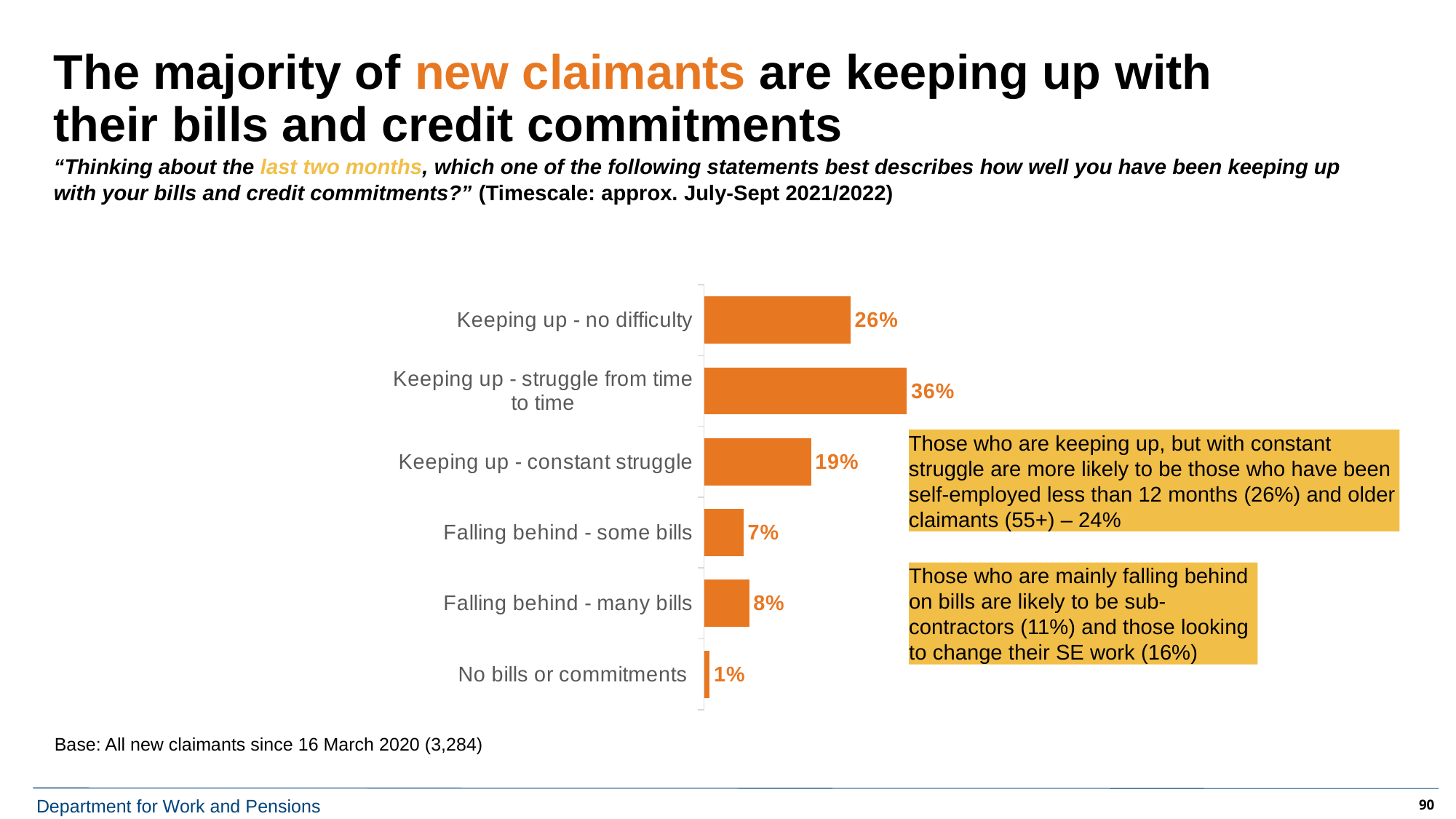
What kind of chart is shown on the slide? Bar chart Which is larger: 'Keeping up - no difficulty' or 'Keeping up - constant struggle'? Keeping up - no difficulty What is the value for 'Keeping up - struggle from time to time'? 36% Which category has the highest value? Keeping up - struggle from time to time What is the combined total of the three 'Keeping up' categories? 81% What percentage of new claimants are falling behind on many bills? 8% What is the difference between 'Falling behind - many bills' and 'Falling behind - some bills'? 1% What is the difference between 'Keeping up - struggle from time to time' and 'Keeping up - constant struggle'? 17% Which category has the lowest value? No bills or commitments How many categories are shown in the chart? 6 What percentage of new claimants are keeping up with no difficulty? 26% What is the value for 'No bills or commitments'? 1%